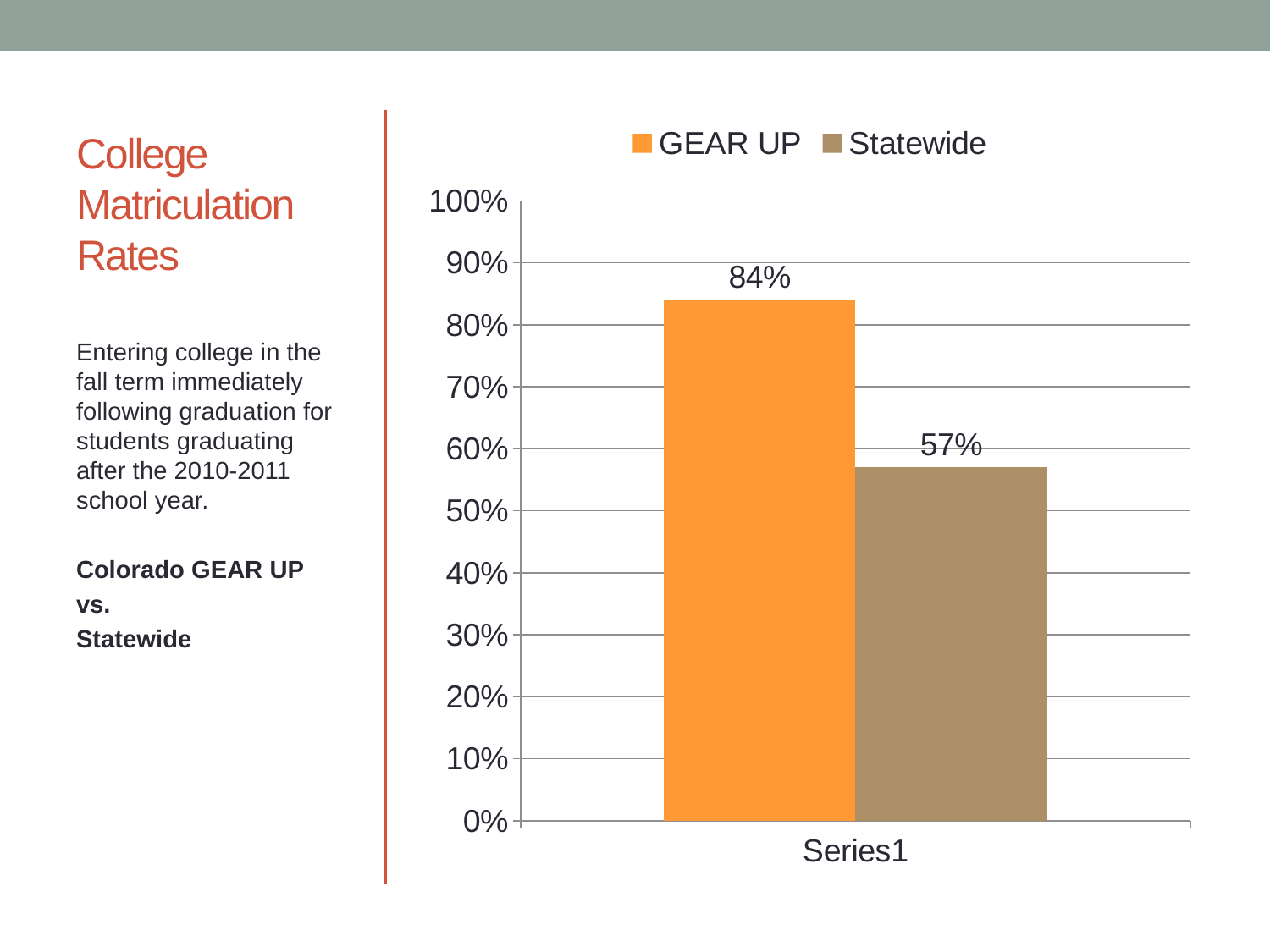
What colour is the GEAR UP bar? orange What kind of chart is shown on the slide? bar chart Which series has the lowest value on the chart? Statewide Which series has the higher value, GEAR UP or Statewide? GEAR UP What is the difference between the GEAR UP and Statewide values? 27% What is the college matriculation rate for GEAR UP? 84% Is the value for GEAR UP greater or less than 80%? greater What is the highest value shown on the y axis? 100% Is the value for Statewide greater or less than 60%? less What is the college matriculation rate for Statewide? 57% What is the label shown on the x axis under the bars? Series1 How many series does the legend list? 2